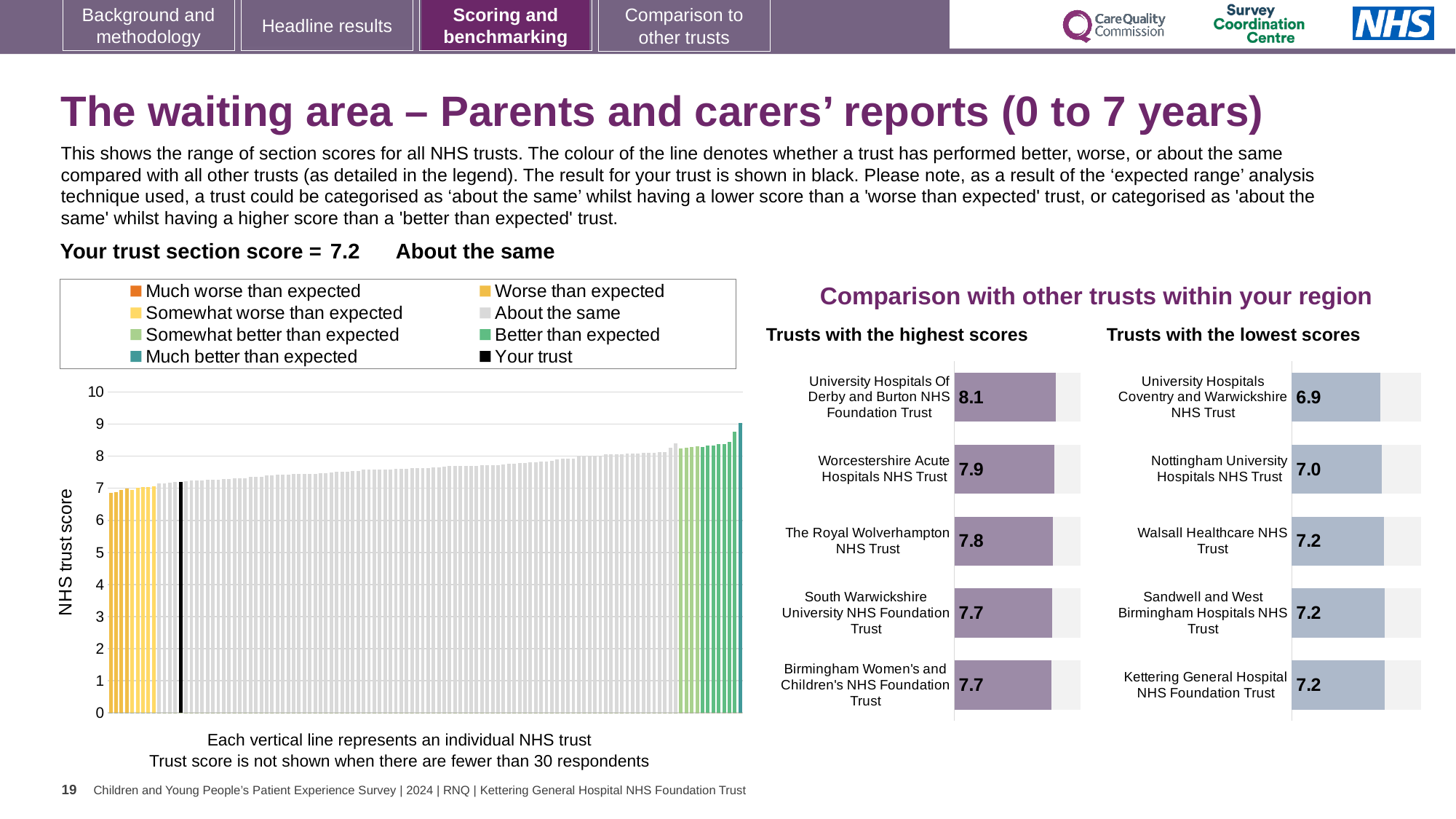
In the 'Trusts with the highest scores' chart, what is the difference between the scores of University Hospitals Of Derby and Burton NHS Foundation Trust and Worcestershire Acute Hospitals NHS Trust? 0.2 In the large chart on the left, is the value of the tallest bar greater or less than 8? greater In the 'Trusts with the highest scores' chart, how many trusts are shown? 5 In the 'Trusts with the lowest scores' chart, which trust has the lowest score? University Hospitals Coventry and Warwickshire NHS Trust In the 'Trusts with the lowest scores' chart, what is the score for University Hospitals Coventry and Warwickshire NHS Trust? 6.9 In the 'Trusts with the lowest scores' chart, what is the difference between the scores of Kettering General Hospital NHS Foundation Trust and University Hospitals Coventry and Warwickshire NHS Trust? 0.3 In the 'Trusts with the highest scores' chart, which has the higher score: Worcestershire Acute Hospitals NHS Trust or The Royal Wolverhampton NHS Trust? Worcestershire Acute Hospitals NHS Trust In the 'Trusts with the highest scores' chart, which trust has the highest score? University Hospitals Of Derby and Burton NHS Foundation Trust In the 'Trusts with the lowest scores' chart, what is the score for Kettering General Hospital NHS Foundation Trust? 7.2 In the 'Trusts with the highest scores' chart, what is the score for University Hospitals Of Derby and Burton NHS Foundation Trust? 8.1 How many entries does the legend above the large chart on the left list? 8 What kind of chart is the large chart on the left of the slide showing NHS trust scores? Bar chart